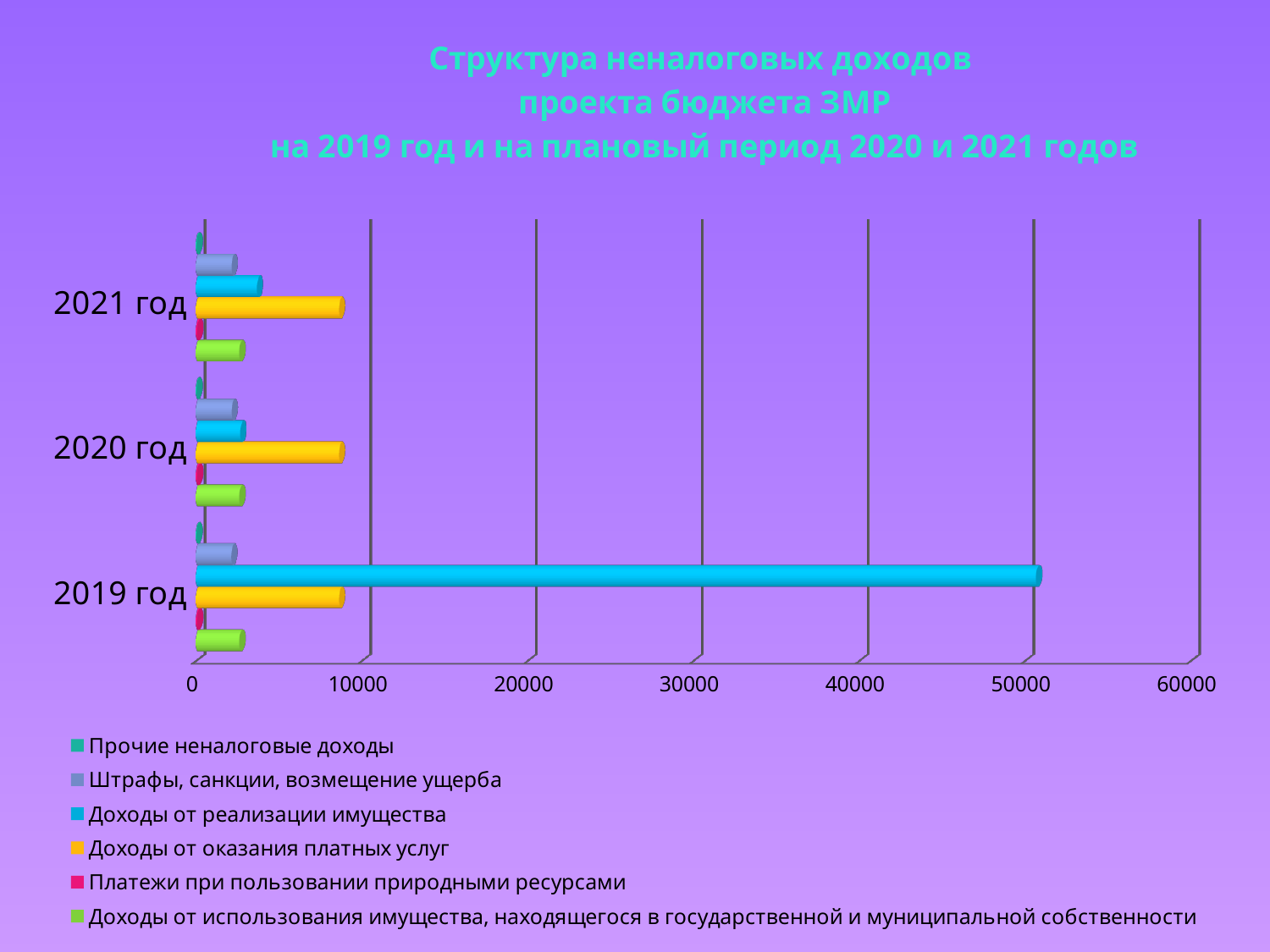
How many year categories are shown on the chart? 3 Which series has the longest bar for 2019 год? Доходы от реализации имущества Is the value for Доходы от оказания платных услуг in 2021 год greater or less than 10000? less How many series does the legend list? 6 Which series is shown in yellow in the legend? Доходы от оказания платных услуг Which is larger for 2021 год: Доходы от оказания платных услуг or Доходы от использования имущества, находящегося в государственной и муниципальной собственности? Доходы от оказания платных услуг Is the value for Доходы от использования имущества, находящегося в государственной и муниципальной собственности in 2020 год greater or less than 10000? less What kind of chart is shown on the slide? bar chart Is the value for Доходы от реализации имущества in 2019 год greater or less than 40000? greater Which year has the larger value for Доходы от реализации имущества: 2019 год or 2020 год? 2019 год What is the highest value shown on the horizontal axis? 60000 Which is larger for 2019 год: Доходы от реализации имущества or Доходы от оказания платных услуг? Доходы от реализации имущества